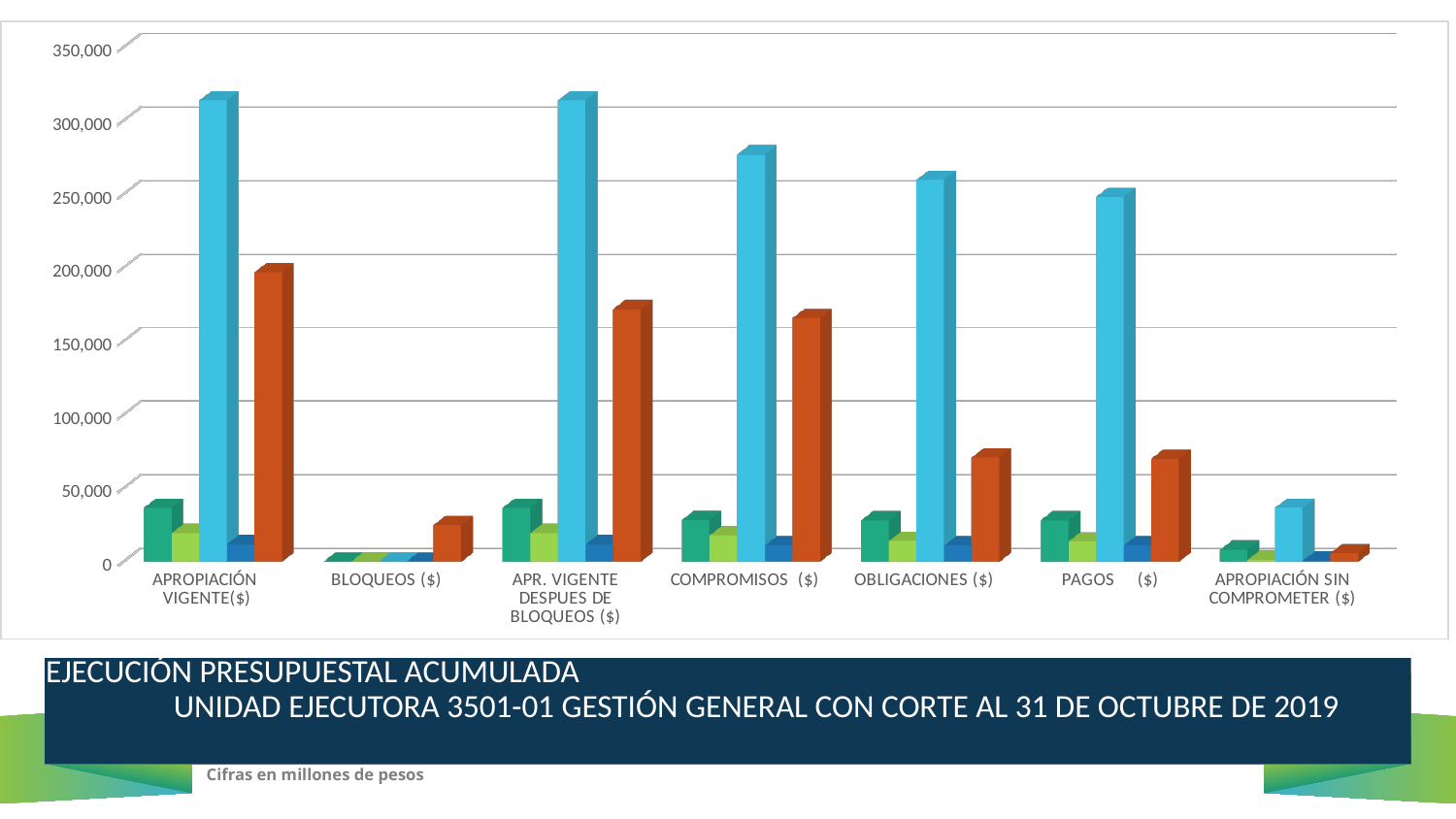
Which has the taller light blue bar, COMPROMISOS ($) or PAGOS ($)? COMPROMISOS ($) What kind of chart is shown on the slide? bar chart According to the note below the chart, in what units are the figures expressed? Cifras en millones de pesos Is the light blue bar for PAGOS ($) greater or less than 200,000? greater Is the orange bar for APROPIACIÓN VIGENTE($) greater or less than 150,000? greater Is the light blue bar for COMPROMISOS ($) greater or less than 250,000? greater Which category has the shortest light blue bar? BLOQUEOS ($) Do the light blue bars rise or fall from APR. VIGENTE DESPUES DE BLOQUEOS ($) through PAGOS ($)? fall Which category has the tallest orange bar? APROPIACIÓN VIGENTE($) How many categories are shown along the x axis of the chart? 7